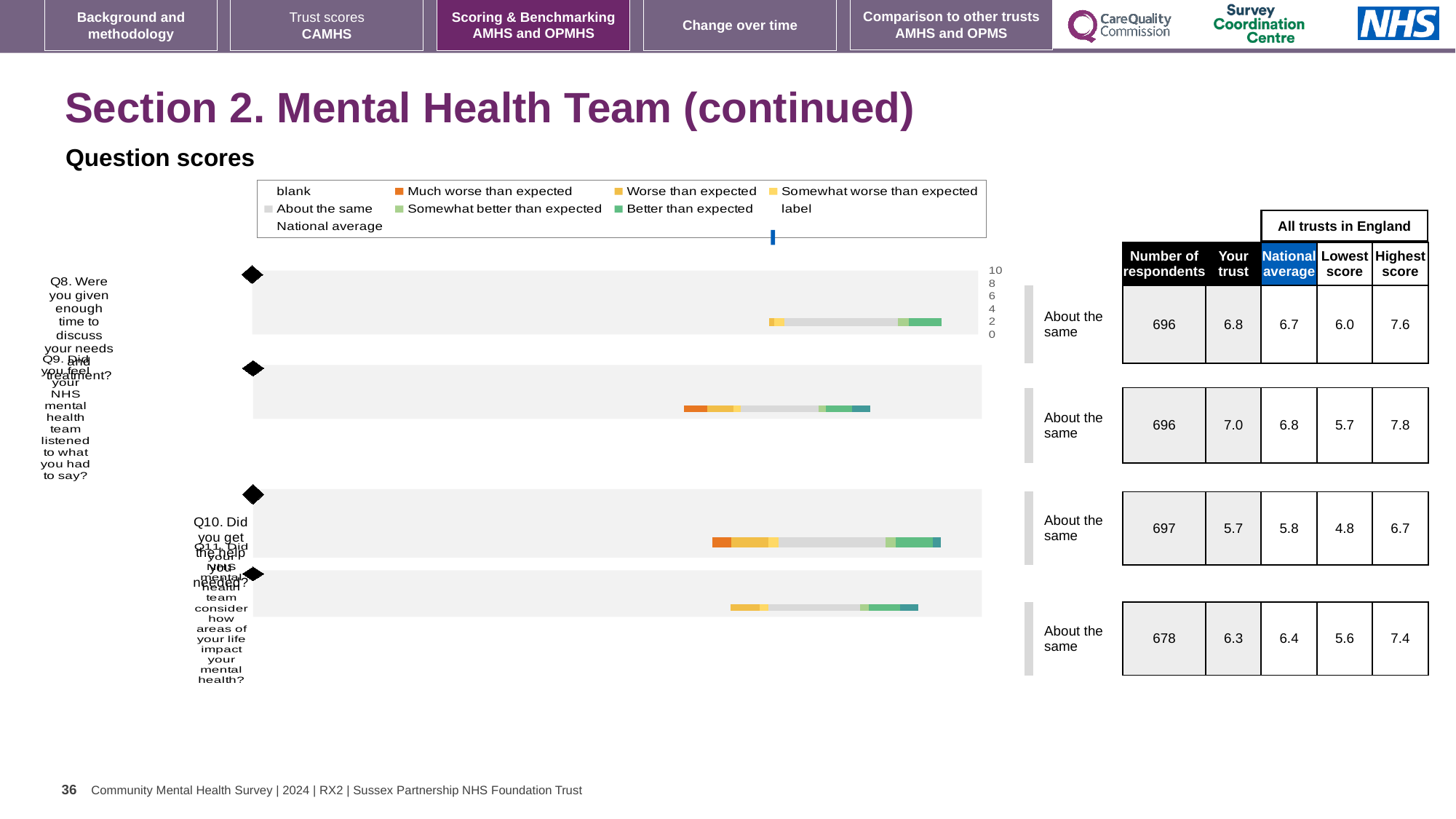
For Q10, what is the difference between the highest score and the lowest score among all trusts in England? 1.9 Which question (Q8 to Q11) has the highest 'Your trust' score? Q9 Which question (Q8 to Q11) has the lowest 'Your trust' score? Q10 For Q11, which is larger: the 'Your trust' score or the national average? National average In the legend, which colour represents 'Much worse than expected'? Orange For Q9, what is the difference between the 'Your trust' score and the national average? 0.2 What kind of chart is used to show the question scores for Q8 to Q11? bar chart For the Q11 chart (team considered how areas of your life impact your mental health), what is the highest score among all trusts in England? 7.4 For the Q10 chart (did you get the help you needed), what is the national average score? 5.8 How many question charts (Q8 to Q11) are shown on the slide? 4 For the Q9 chart (mental health team listened to what you had to say), what is the number of respondents? 696 For the Q8 chart (enough time to discuss your needs and treatment), what is the 'Your trust' score shown in the table? 6.8